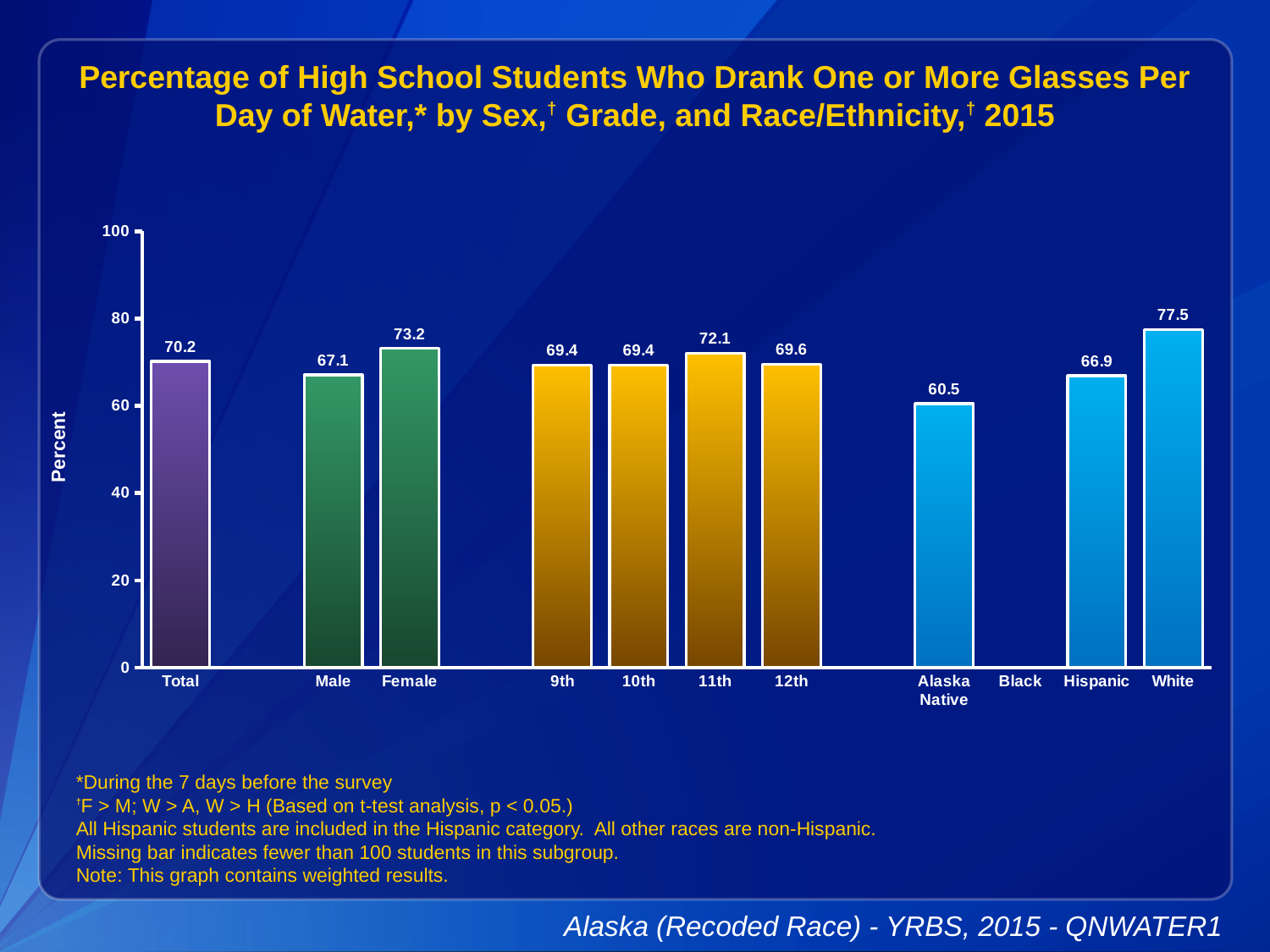
Which category has the lowest value among the bars shown? Alaska Native Which category label has no bar shown? Black What is the value for Female? 73.2 Is the value for 12th grade greater or less than 60? greater What is the value for Total? 70.2 How many bars are plotted on the chart? 11 What is the value for Alaska Native? 60.5 Which category has the highest value? White Which is larger, the value for Hispanic or the value for White? White What is the value for 11th grade? 72.1 What is the difference between the Female and Male values? 6.1 What kind of chart is shown? bar chart